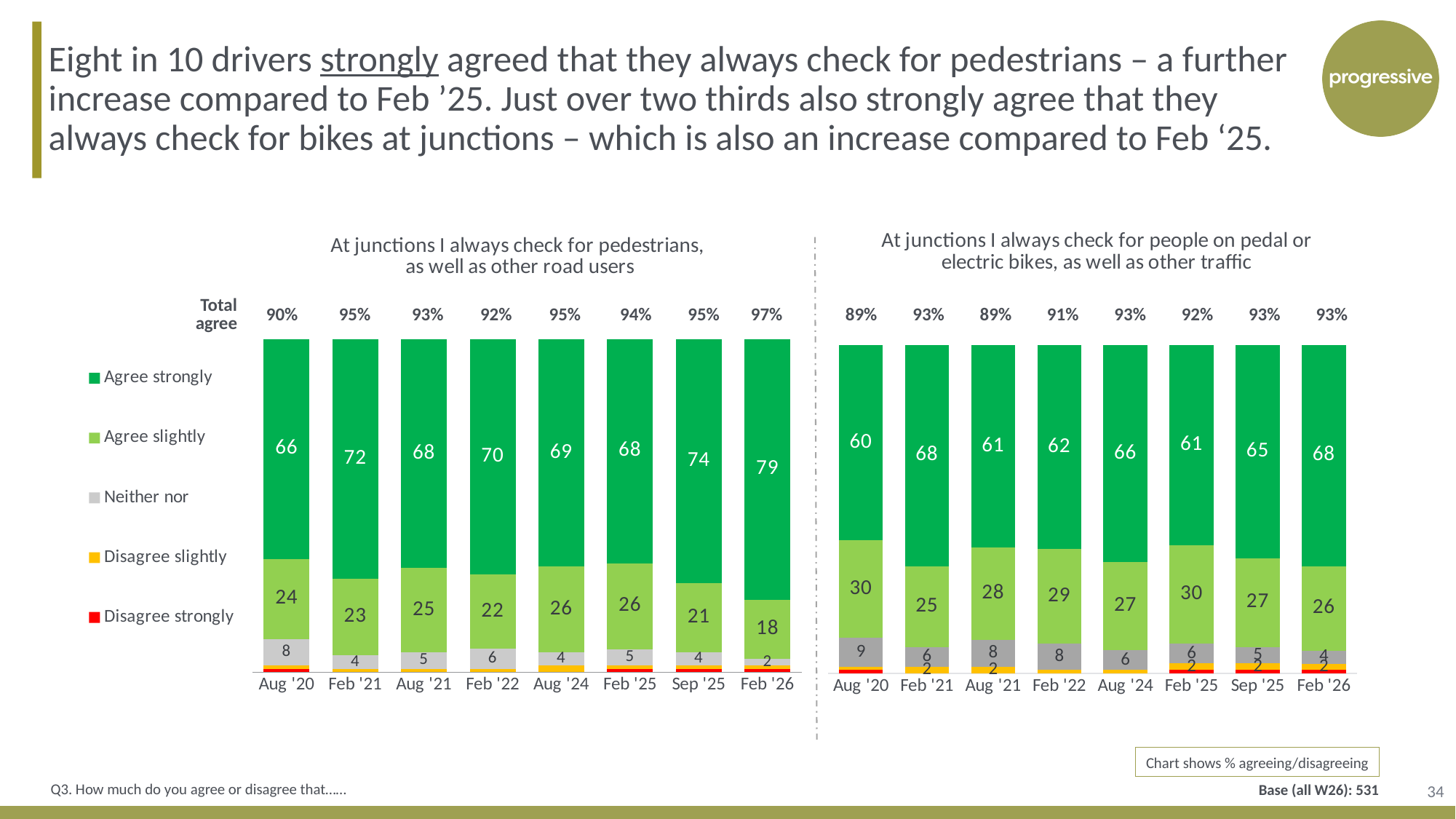
In the right chart (bikes), what is the difference between the Agree strongly values for Feb '26 and Sep '25? 3 In the chart 'At junctions I always check for pedestrians, as well as other road users', what is the Agree strongly value for Feb '26? 79 What kind of chart is used on this slide? Stacked bar chart In the chart 'At junctions I always check for people on pedal or electric bikes, as well as other traffic', what is the Agree slightly value for Feb '25? 30 In the left chart (pedestrians), which period has the highest Agree strongly value? Feb '26 How many time periods are shown on the x axis of the left chart (pedestrians)? 8 In the left chart (pedestrians), what is the Total agree figure shown for Aug '20? 90% In the left chart (pedestrians), what is the Neither nor value for Feb '26? 2 How many series does the legend list? 5 In the right chart (bikes), which period has the lowest Agree strongly value? Aug '20 In the left chart (pedestrians), what is the difference between the Agree strongly values for Feb '26 and Feb '25? 11 In the right chart (bikes), which is larger: the Agree slightly value for Aug '20 or for Feb '21? Aug '20